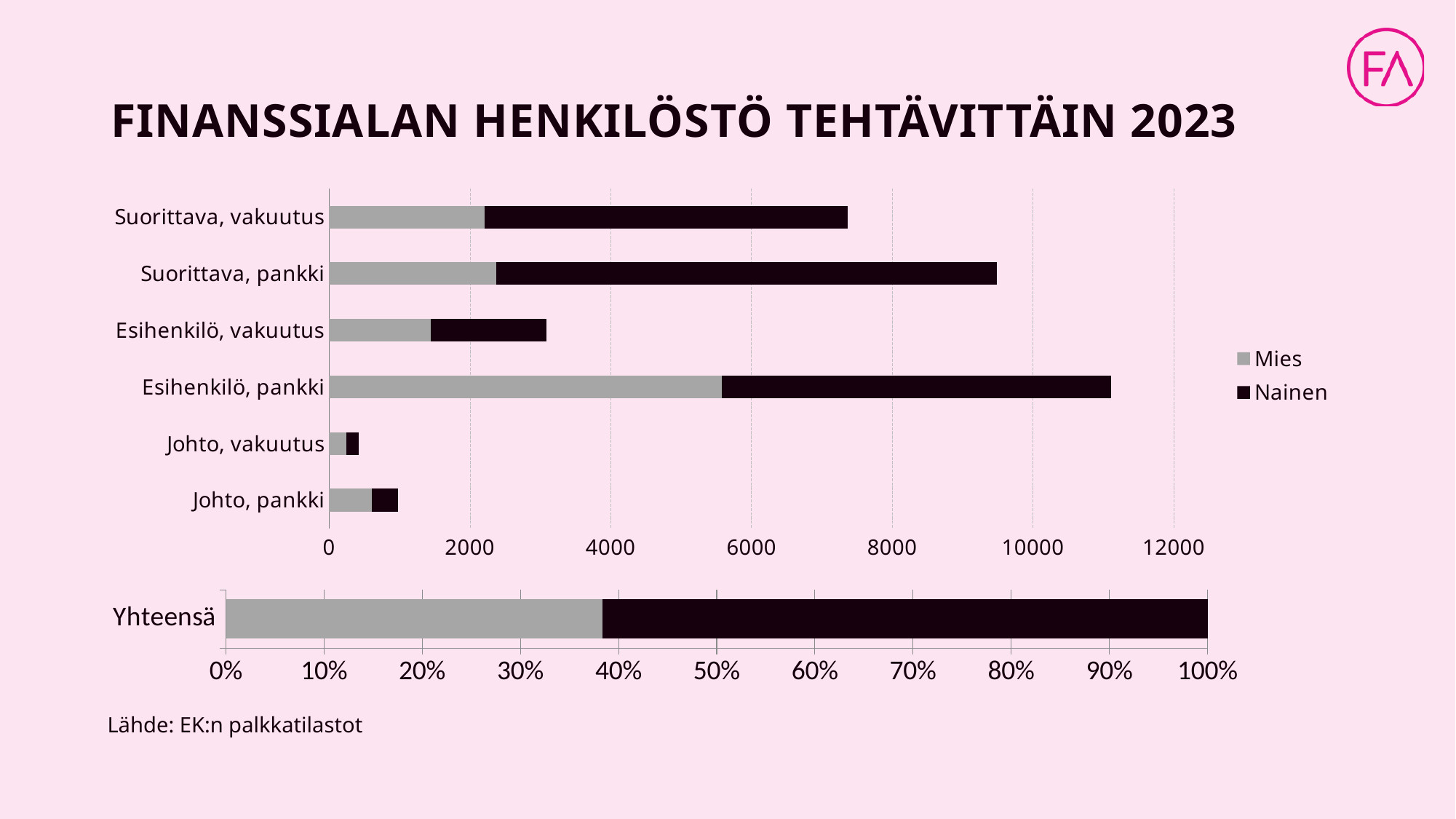
In the lower Yhteensä chart, is the Mies share greater or less than 50%? less In the upper chart, which category has the longest total bar? Esihenkilö, pankki In the upper chart, is the total bar for Esihenkilö, vakuutus greater or less than 4000? less What kind of chart is the upper chart on the slide? bar chart How many series does the legend list? 2 In the upper chart, how many categories are shown on the vertical axis? 6 In the upper chart, which has the longer total bar: Suorittava, pankki or Suorittava, vakuutus? Suorittava, pankki In the upper chart, is the total bar for Esihenkilö, pankki greater or less than 10000? greater In the upper chart, which category has the shortest total bar? Johto, vakuutus What are the two entries in the legend? Mies, Nainen